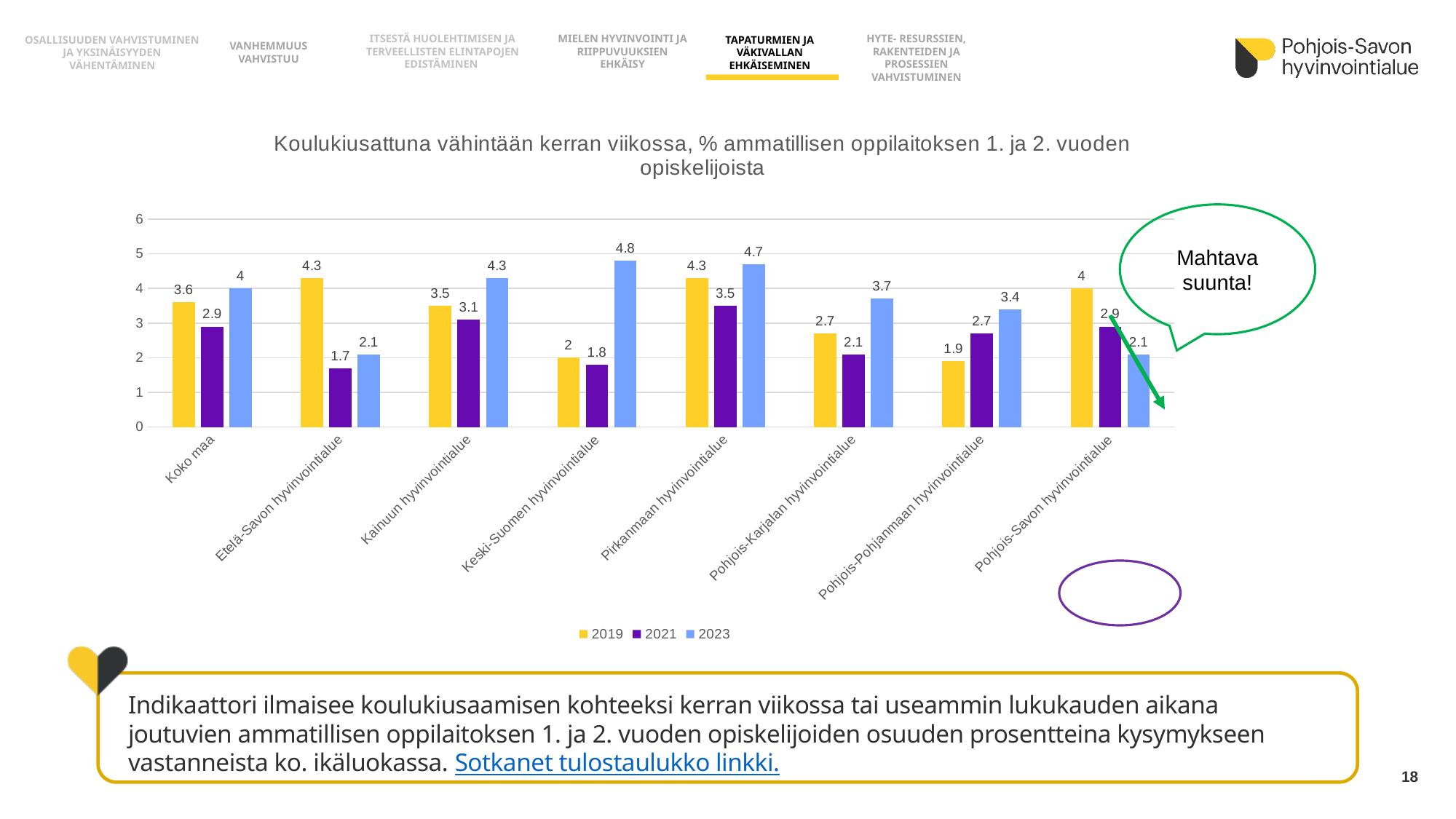
What is the 2023 value for Keski-Suomen hyvinvointialue? 4.8 What is the 2019 value for Pohjois-Savon hyvinvointialue? 4 Which category has the highest 2023 value? Keski-Suomen hyvinvointialue How many series does the legend list? 3 Do the values for Pohjois-Savon hyvinvointialue rise or fall from 2019 to 2023? Fall What kind of chart is shown on the slide? Bar chart Which category has the lowest 2021 value? Etelä-Savon hyvinvointialue What text is written in the speech bubble next to the chart? Mahtava suunta! Which is larger for Pirkanmaan hyvinvointialue, the 2019 value or the 2023 value? 2023 What is the 2021 value for Etelä-Savon hyvinvointialue? 1.7 How many categories are shown on the x axis? 8 What is the difference between the 2019 and 2023 values for Pohjois-Savon hyvinvointialue? 1.9